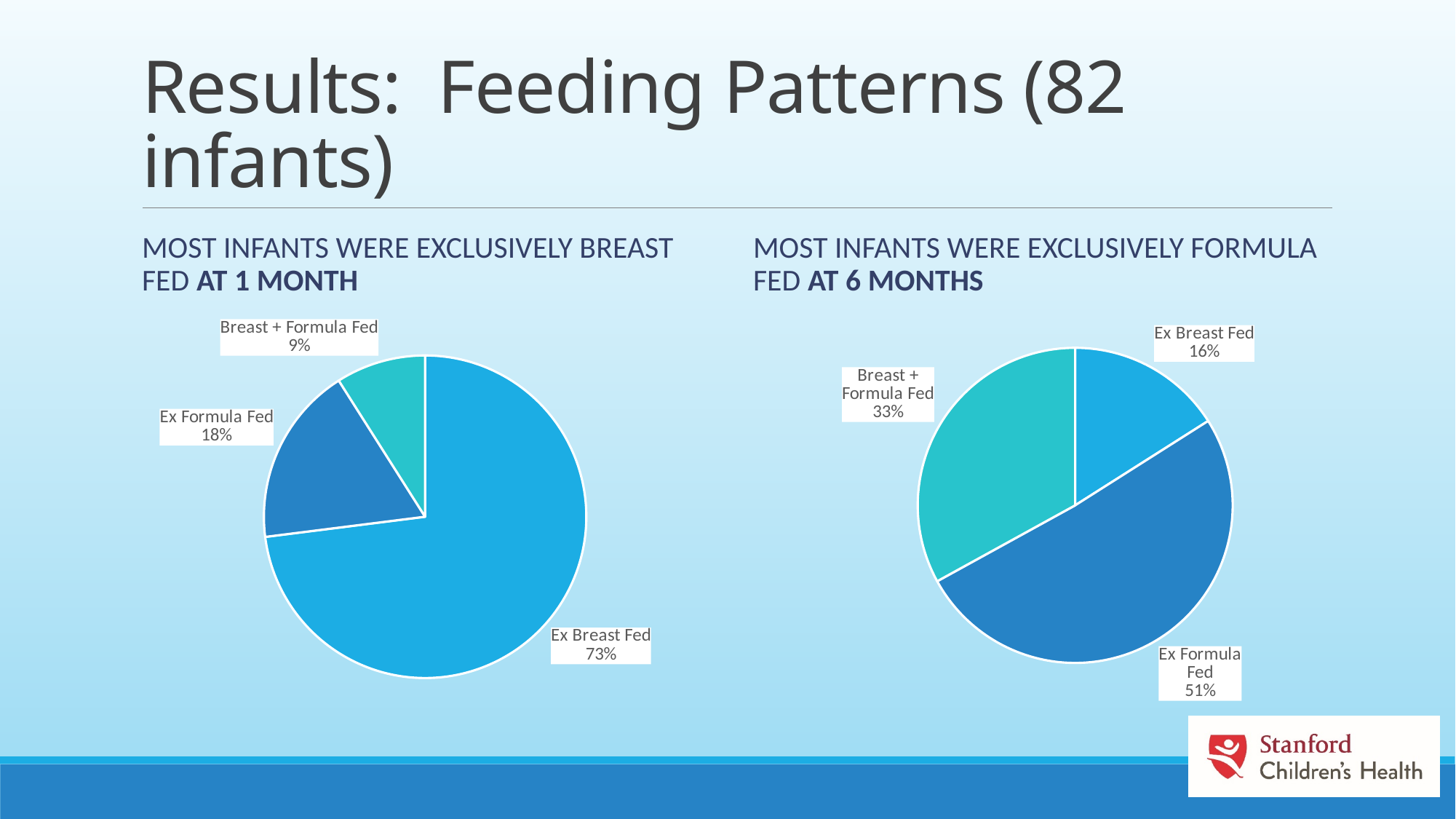
In the right pie chart (at 6 months), which is larger: Breast + Formula Fed or Ex Breast Fed? Breast + Formula Fed What type of chart is used on the left side of the slide? Pie chart In the left pie chart (at 1 month), what share of infants were Ex Formula Fed? 18% In the right pie chart (at 6 months), what share of infants were Ex Formula Fed? 51% In the right pie chart (at 6 months), what share of infants were Ex Breast Fed? 16% In the left pie chart (at 1 month), which category has the largest slice? Ex Breast Fed In the right pie chart (at 6 months), what share of infants were Breast + Formula Fed? 33% In the left pie chart (at 1 month), what share of infants were Ex Breast Fed? 73% In the right pie chart (at 6 months), which category has the smallest slice? Ex Breast Fed In the left pie chart (at 1 month), what share of infants were Breast + Formula Fed? 9% In the left pie chart (at 1 month), what is the difference in percentage points between Ex Breast Fed and Ex Formula Fed? 55 How many slices does the right pie chart (at 6 months) have? 3